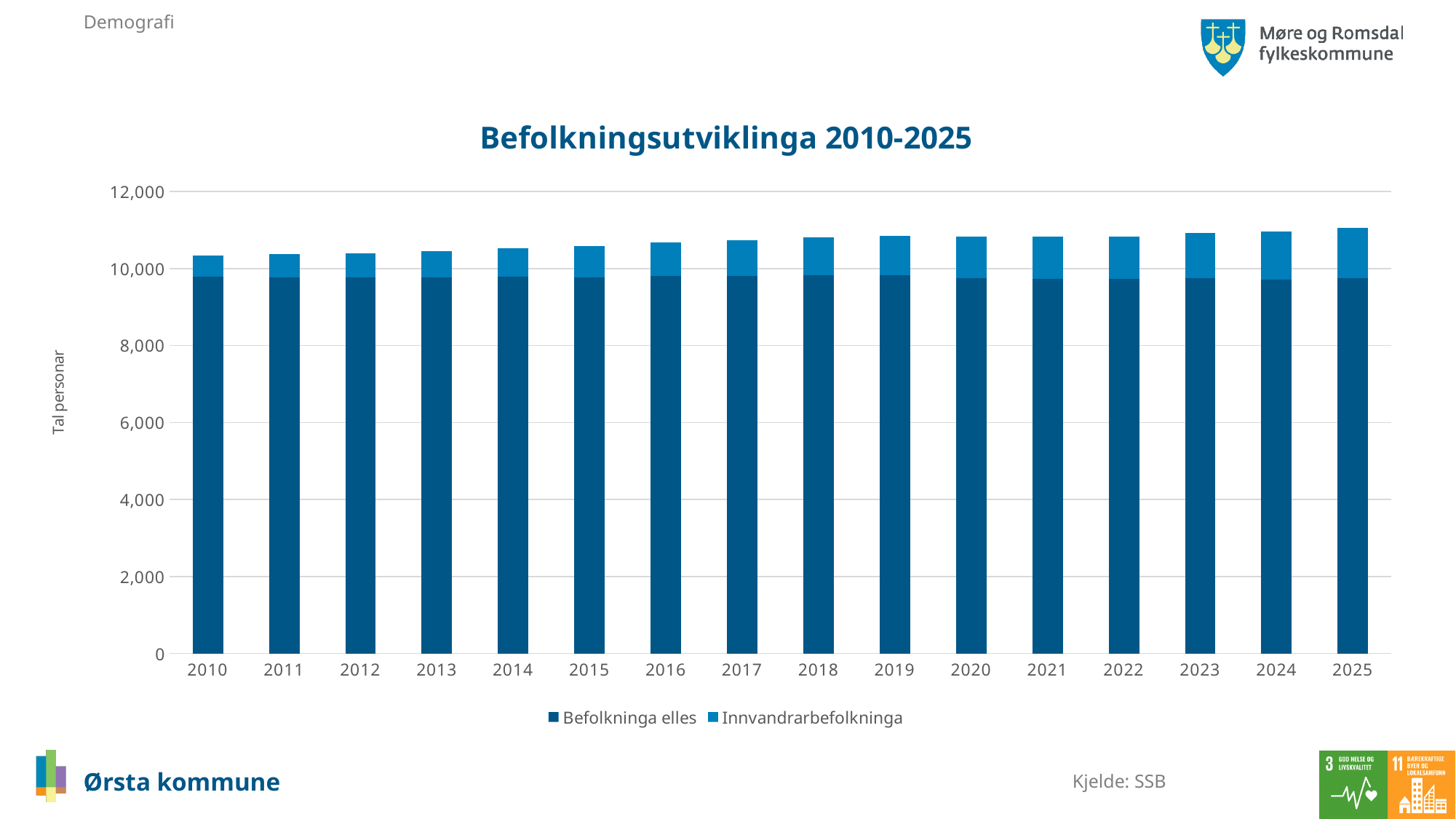
Which is larger, the total bar for 2010 or the total bar for 2025? 2025 How many years are shown on the x axis? 16 Is the value for Innvandrarbefolkninga in 2025 greater or less than 2,000? less What is the label of the y axis? Tal personar Is the total bar height for 2010 greater or less than 10,000? greater What is the title of the chart? Befolkningsutviklinga 2010-2025 Do the total bar heights generally rise or fall from 2010 to 2025? rise Is the value for Befolkninga elles in 2010 greater or less than 10,000? less How many series does the legend list? 2 What kind of chart is shown on the slide? bar chart Which year has the highest total bar? 2025